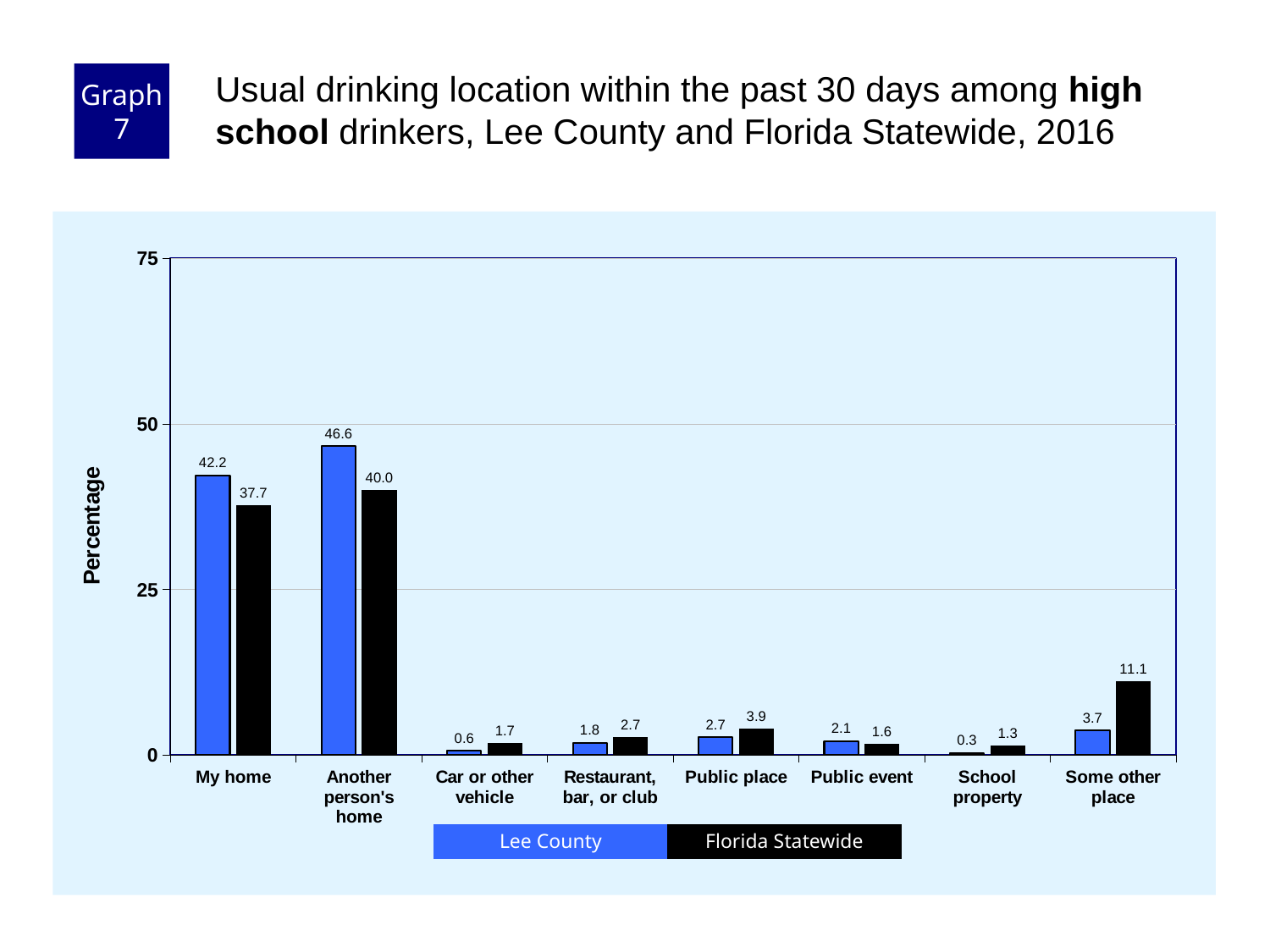
What is the Florida Statewide value for "My home"? 37.7 What is the Lee County value for "Another person's home"? 46.6 What is the difference between the Lee County and Florida Statewide values for "My home"? 4.5 What is the label of the y axis? Percentage How many categories are shown on the x axis? 8 What is the Florida Statewide value for "Some other place"? 11.1 Is the Lee County value for "Another person's home" greater or less than 50? less What kind of chart is shown on the slide? Bar chart Which category has the lowest Lee County value? School property How many series does the legend list? 2 For "Public place", which is larger: the Lee County value or the Florida Statewide value? Florida Statewide Which category has the highest Lee County value? Another person's home